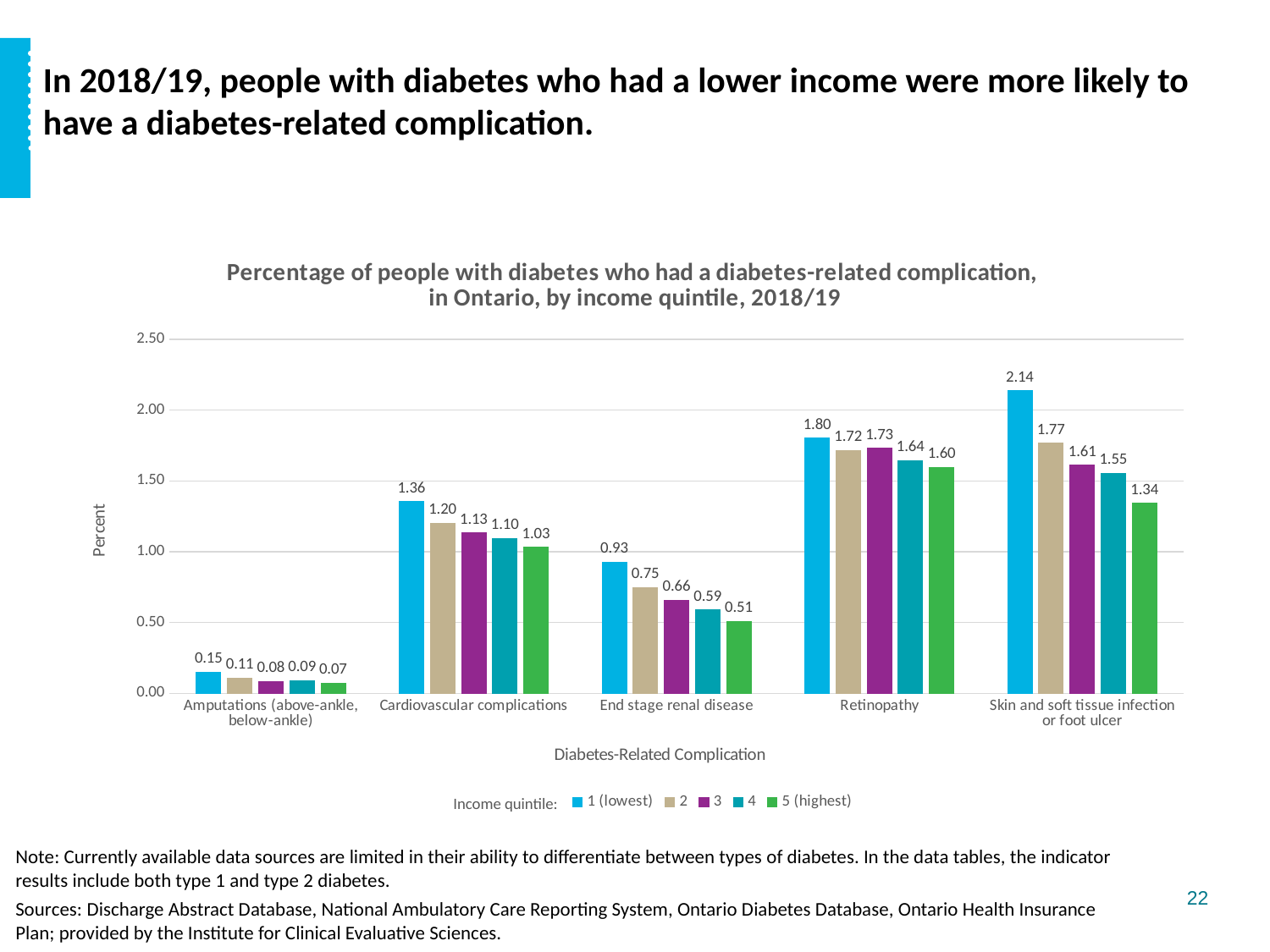
What is the value for income quintile 5 (highest) for Cardiovascular complications? 1.03 How many diabetes-related complication categories are shown on the x axis? 5 How many income quintile series does the legend list? 5 Which complication has the highest value for income quintile 1 (lowest)? Skin and soft tissue infection or foot ulcer Which complication has the lowest value for income quintile 5 (highest)? Amputations (above-ankle, below-ankle) What is the label of the y axis? Percent Which is larger for End stage renal disease: income quintile 2 or income quintile 4? Income quintile 2 What is the difference between income quintile 1 (lowest) and income quintile 5 (highest) for Retinopathy? 0.20 What is the value for income quintile 3 for End stage renal disease? 0.66 What is the value for income quintile 1 (lowest) for Skin and soft tissue infection or foot ulcer? 2.14 What kind of chart is shown on the slide? Bar chart Is the value for income quintile 1 (lowest) for Cardiovascular complications greater or less than 1.50? less